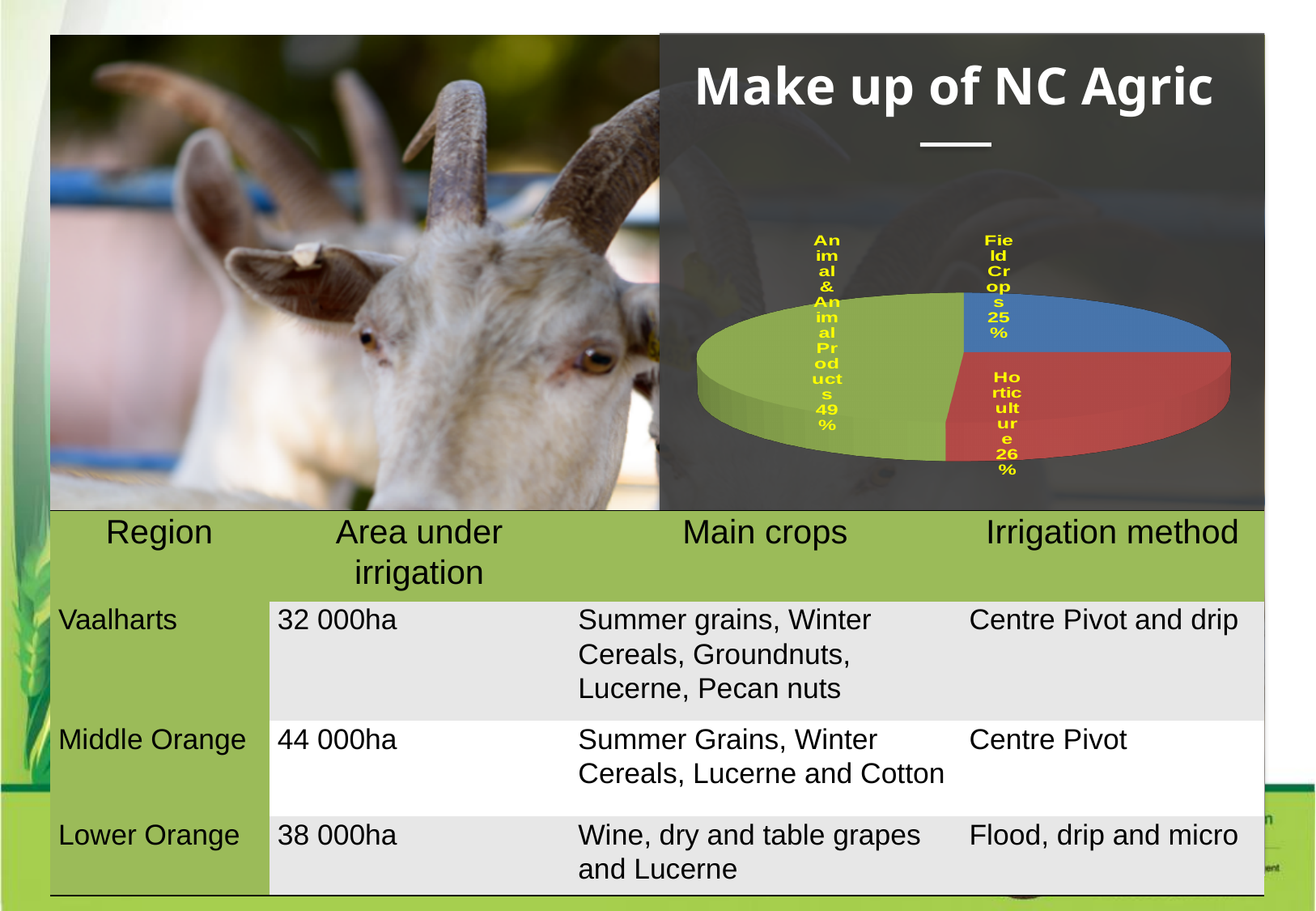
Is the Animal & Animal Products share greater or less than 40%? greater What kind of chart is shown under the title "Make up of NC Agric"? pie chart Which slice of the pie chart is the largest? Animal & Animal Products What share of the pie does Horticulture have? 26% What is the difference in percentage points between the Animal & Animal Products slice and the Horticulture slice? 23 What share of the pie does Animal & Animal Products have? 49% What is the difference in percentage points between the Horticulture slice and the Field Crops slice? 1 What is the title of the pie chart? Make up of NC Agric What share of the pie does Field Crops have? 25% Which slice of the pie chart is the smallest? Field Crops What colour is the Field Crops slice of the pie chart? blue How many slices does the pie chart have? 3